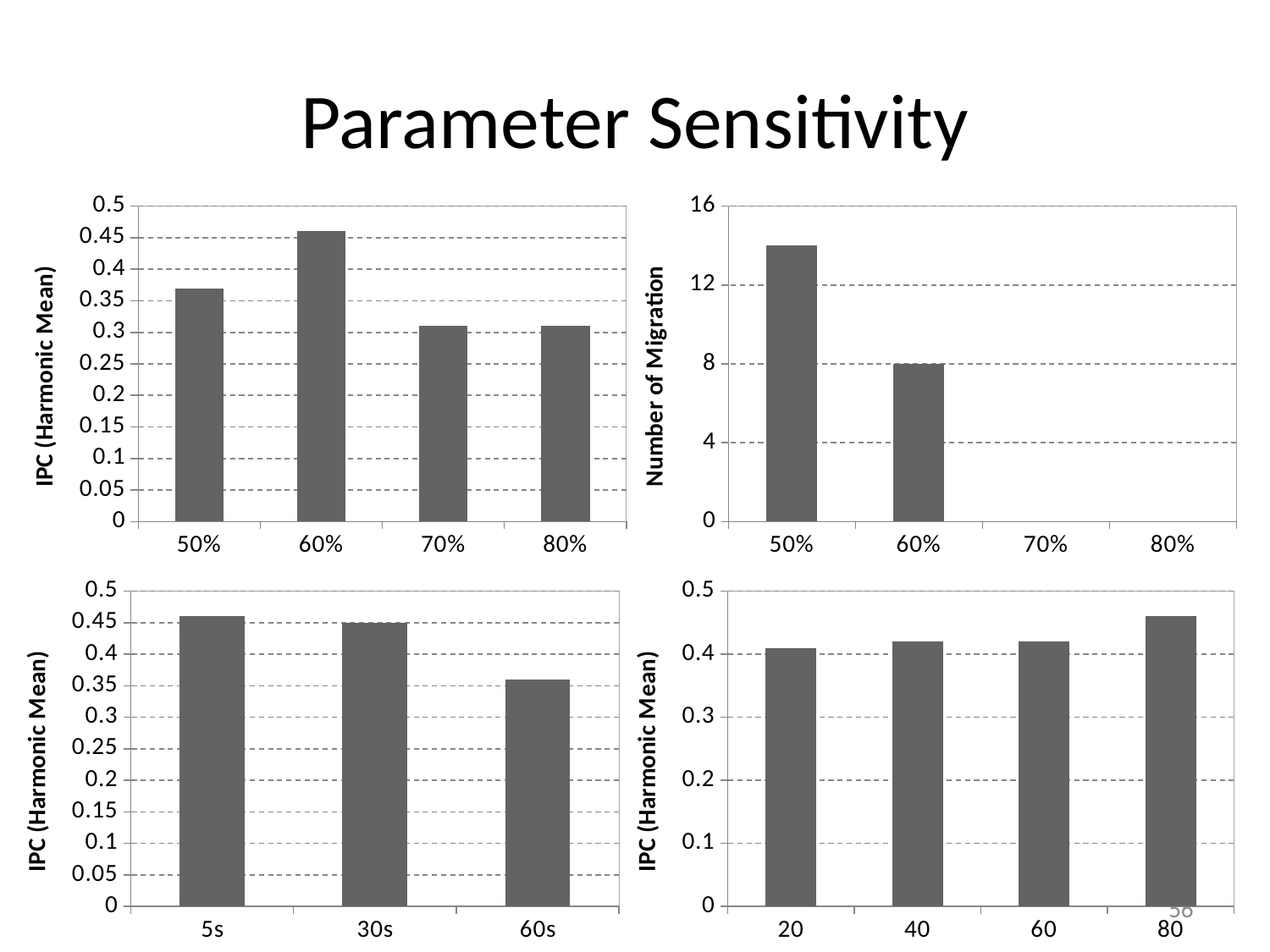
How many categories are shown on the x axis of the top-left chart? 4 What is the y-axis label of the top-right chart? Number of Migration In the bottom-left chart, what is the IPC (Harmonic Mean) for 30s? 0.45 In the top-right chart, which category has the highest Number of Migration? 50% In the top-left chart, is the value for 60% greater or less than 0.4? greater In the top-left chart, is the value for 70% greater or less than 0.35? less In the bottom-right chart, which category has the highest IPC (Harmonic Mean)? 80 In the bottom-left chart, which category has the lowest IPC (Harmonic Mean)? 60s In the top-left chart, which category has the highest IPC (Harmonic Mean)? 60% In the top-right chart, is the value for 50% greater or less than 12? greater In the top-right chart, what is the Number of Migration for 60%? 8 What kind of chart is the top-left chart on the slide? bar chart